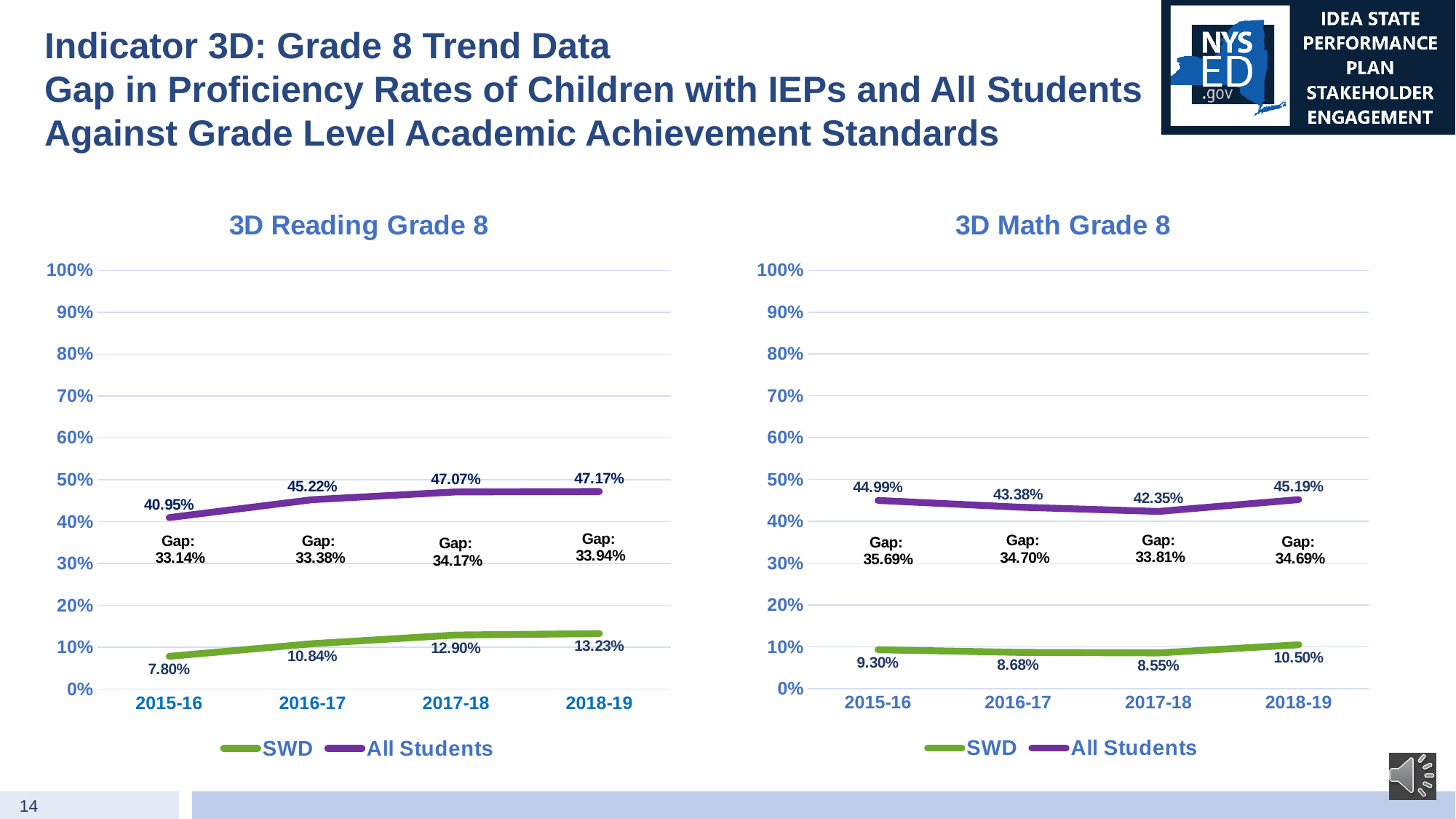
In the 3D Reading Grade 8 chart, which year has the highest SWD value? 2018-19 What kind of chart is the 3D Reading Grade 8 chart? Line chart In the 3D Reading Grade 8 chart, does the SWD series rise or fall from 2015-16 to 2018-19? Rise In the 3D Math Grade 8 chart, what is the SWD value for 2017-18? 8.55% In the 3D Reading Grade 8 chart, what is the gap between All Students and SWD in 2017-18? 34.17% In the 3D Reading Grade 8 chart, what is the All Students value for 2018-19? 47.17% In the 3D Math Grade 8 chart, which year has the lowest All Students value? 2017-18 How many series does the legend of the 3D Math Grade 8 chart list? 2 In the 3D Reading Grade 8 chart, how many years are shown on the x axis? 4 In the 3D Math Grade 8 chart, which is larger: the SWD value for 2015-16 or the SWD value for 2018-19? 2018-19 In the 3D Reading Grade 8 chart, what is the SWD value for 2015-16? 7.80% In the 3D Math Grade 8 chart, what is the All Students value for 2016-17? 43.38%